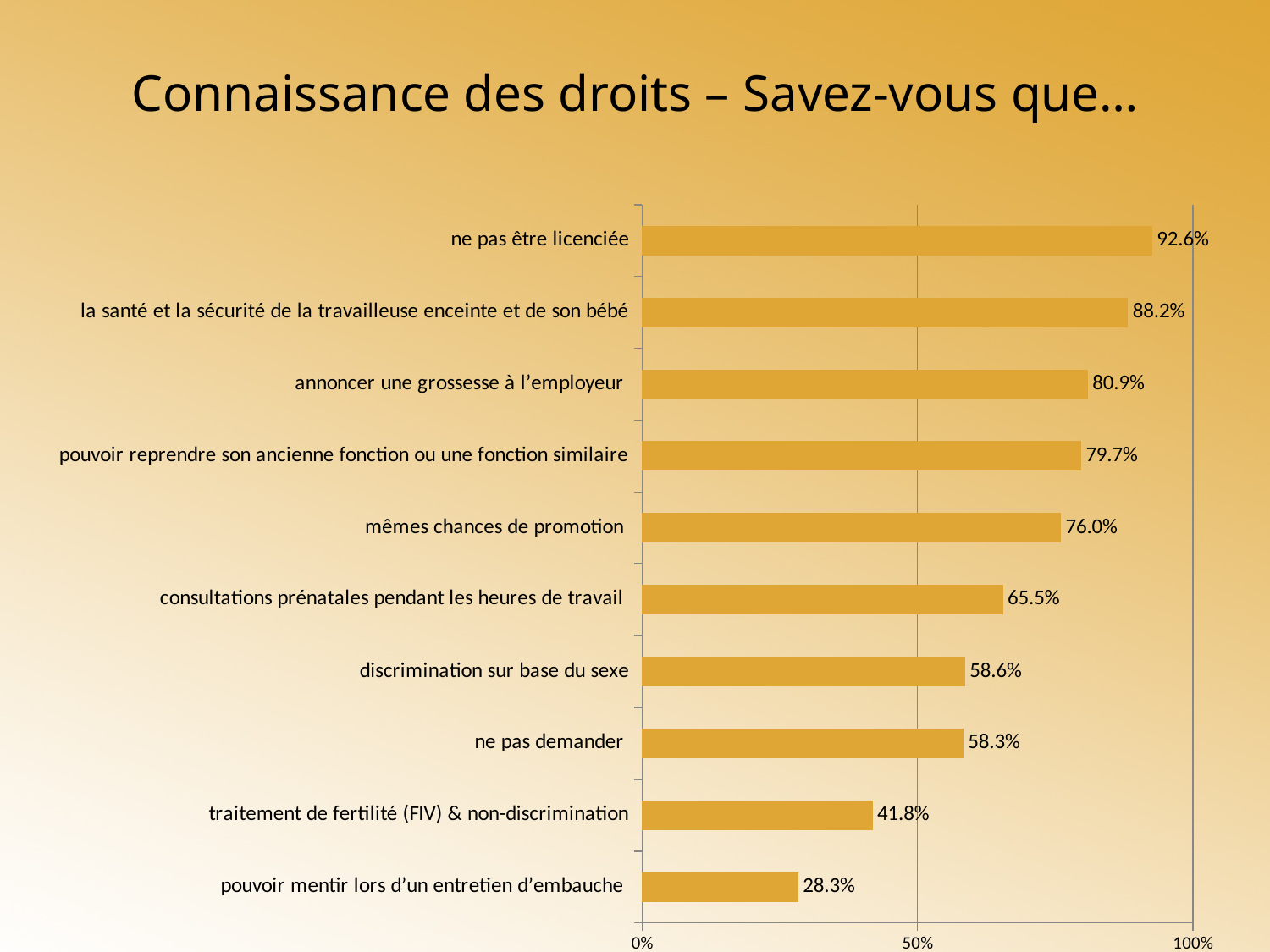
Which is larger: the value for "annoncer une grossesse à l'employeur" or the value for "mêmes chances de promotion"? annoncer une grossesse à l'employeur What is the value for "traitement de fertilité (FIV) & non-discrimination"? 41.8% What is the value for "pouvoir mentir lors d'un entretien d'embauche"? 28.3% What is the difference between the values for "ne pas être licenciée" and "pouvoir mentir lors d'un entretien d'embauche"? 64.3% What is the value for "ne pas être licenciée"? 92.6% Is the value for "discrimination sur base du sexe" greater or less than 50%? greater Which category has the highest value? ne pas être licenciée What is the title of the slide? Connaissance des droits – Savez-vous que… Which category has the lowest value? pouvoir mentir lors d'un entretien d'embauche What is the value for "consultations prénatales pendant les heures de travail"? 65.5% What kind of chart is shown on the slide? bar chart How many categories are shown in the chart? 10